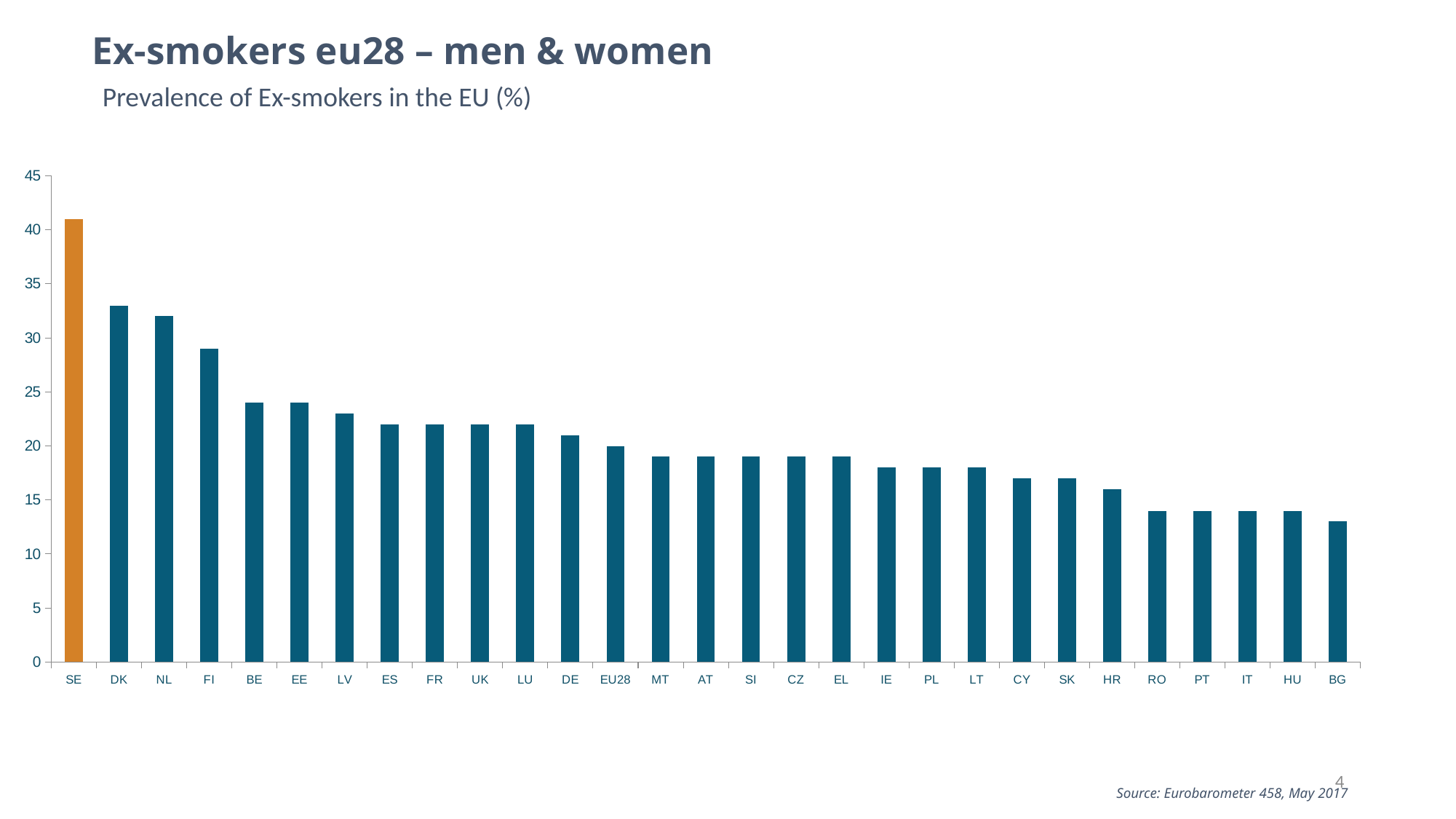
How many bars are plotted in the chart? 29 Which country has the lowest prevalence of ex-smokers? BG Which is larger, the value for FI or the value for BE? FI Is the value for DK greater or less than 30? greater Do the values rise or fall moving from left to right along the x axis? fall Is the value for EU28 greater or less than 25? less Is the value for BG greater or less than 15? less What kind of chart is shown on the slide? bar chart Which bar is shown in a different colour (orange) from the others? SE Which country has the highest prevalence of ex-smokers? SE